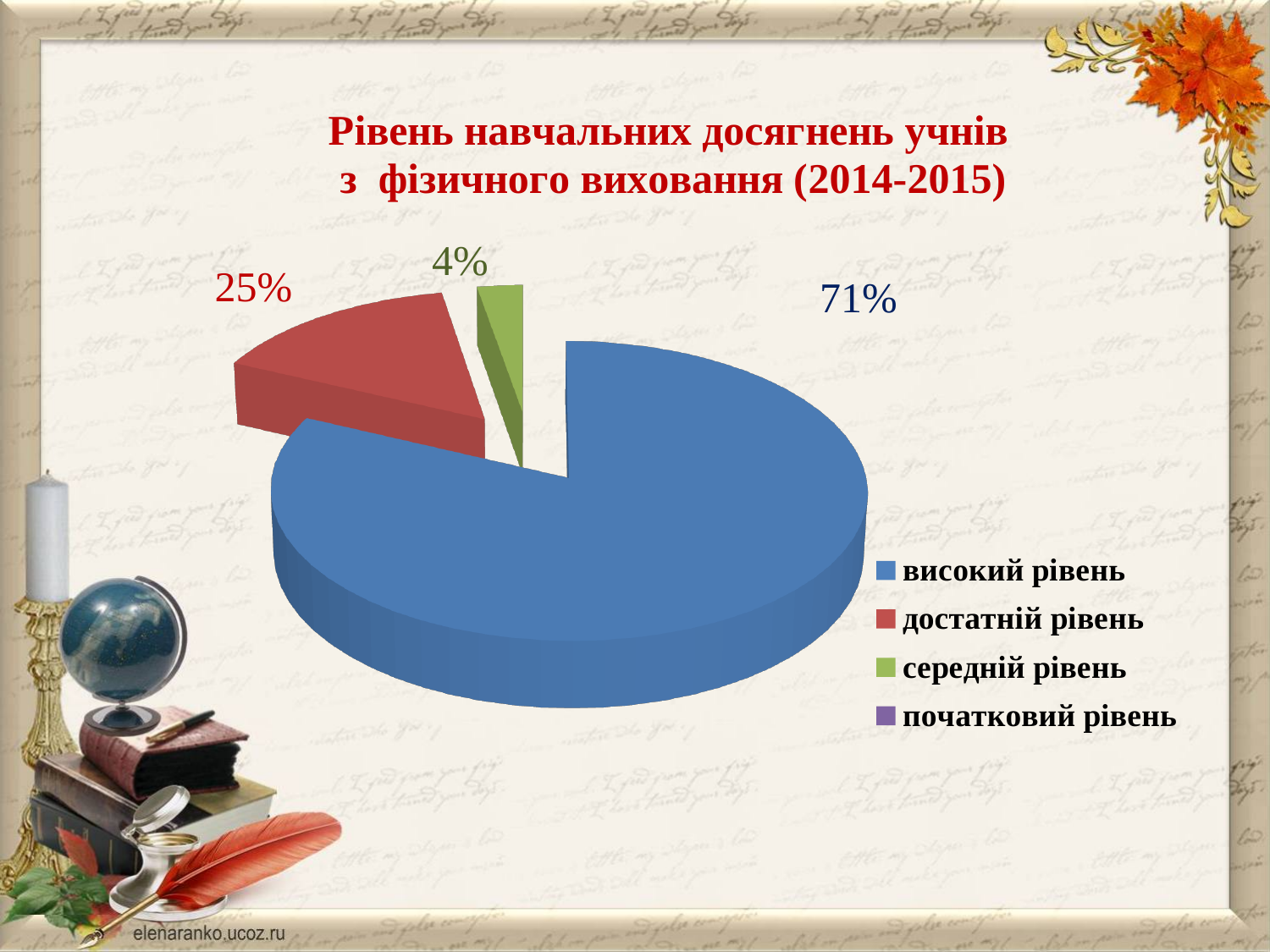
What colour is the slice for високий рівень? blue How many entries does the legend list? 4 What share of the pie does високий рівень have? 71% What is the title of the chart? Рівень навчальних досягнень учнів з фізичного виховання (2014-2015) Which of the labelled slices is the smallest? середній рівень Which level has the largest slice of the pie? високий рівень What is the difference in percentage points between достатній рівень and середній рівень? 21 What kind of chart is shown on the slide? pie chart What is the difference in percentage points between високий рівень and достатній рівень? 46 What share of the pie does середній рівень have? 4% What share of the pie does достатній рівень have? 25% Which is larger, the slice for достатній рівень or the slice for середній рівень? достатній рівень